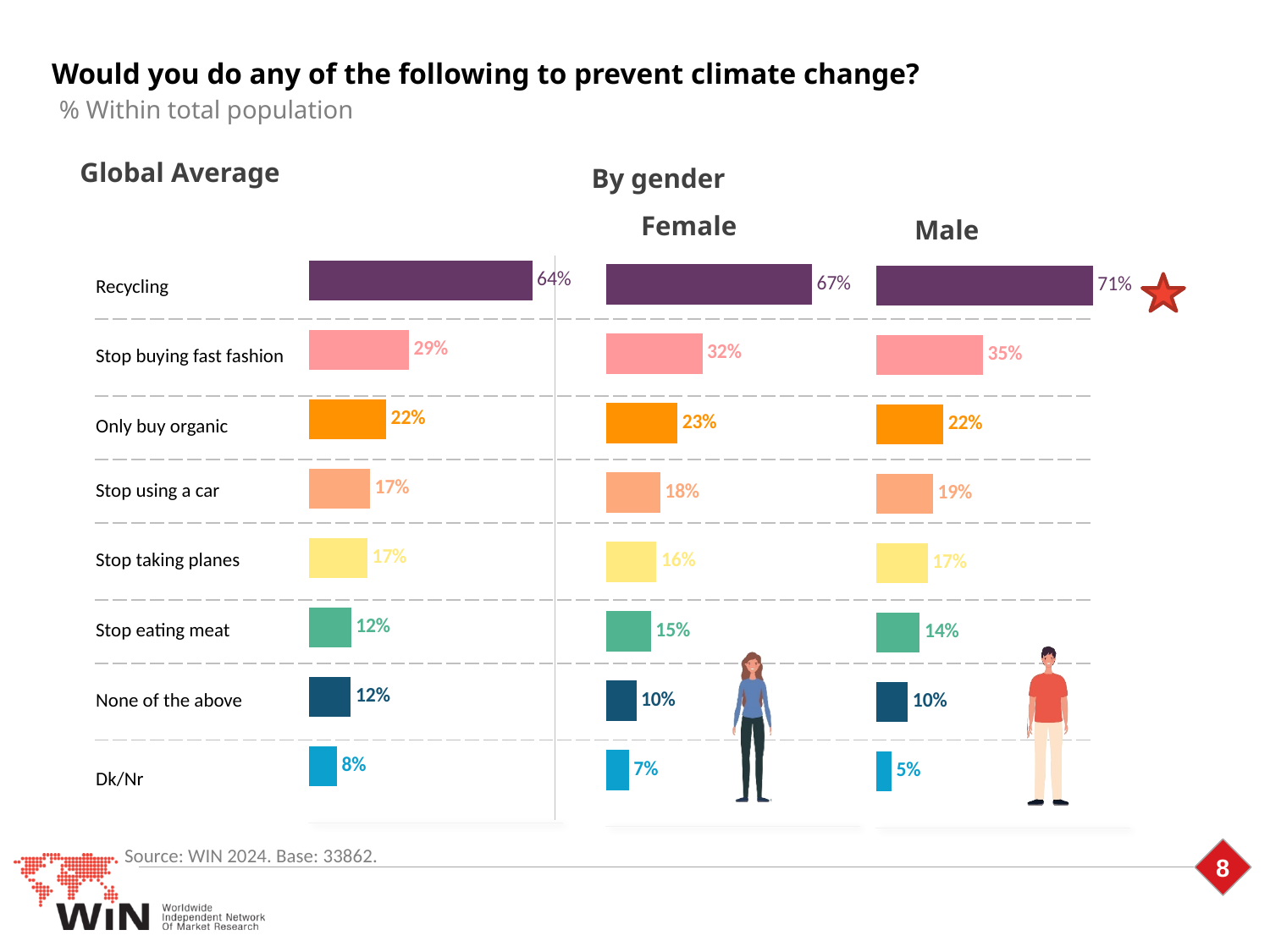
In the Global Average chart, what is the difference between Stop buying fast fashion and Only buy organic? 7% Which is larger: the Female value for Stop using a car or the Male value for Stop using a car? Male In the Male chart, what is the value for Dk/Nr? 5% In the Global Average chart, what is the value for Recycling? 64% In the Male chart, what is the value for Stop eating meat? 14% In the Female chart, what is the value for Stop buying fast fashion? 32% In the Male chart, which category has the highest value? Recycling In the Female chart, which category has the lowest value? Dk/Nr How many categories are shown in the Global Average chart? 8 What kind of chart is the Global Average chart? Bar chart What is the difference between the Male and Female values for Recycling? 4% What is the title of the slide's question shown above the charts? Would you do any of the following to prevent climate change?